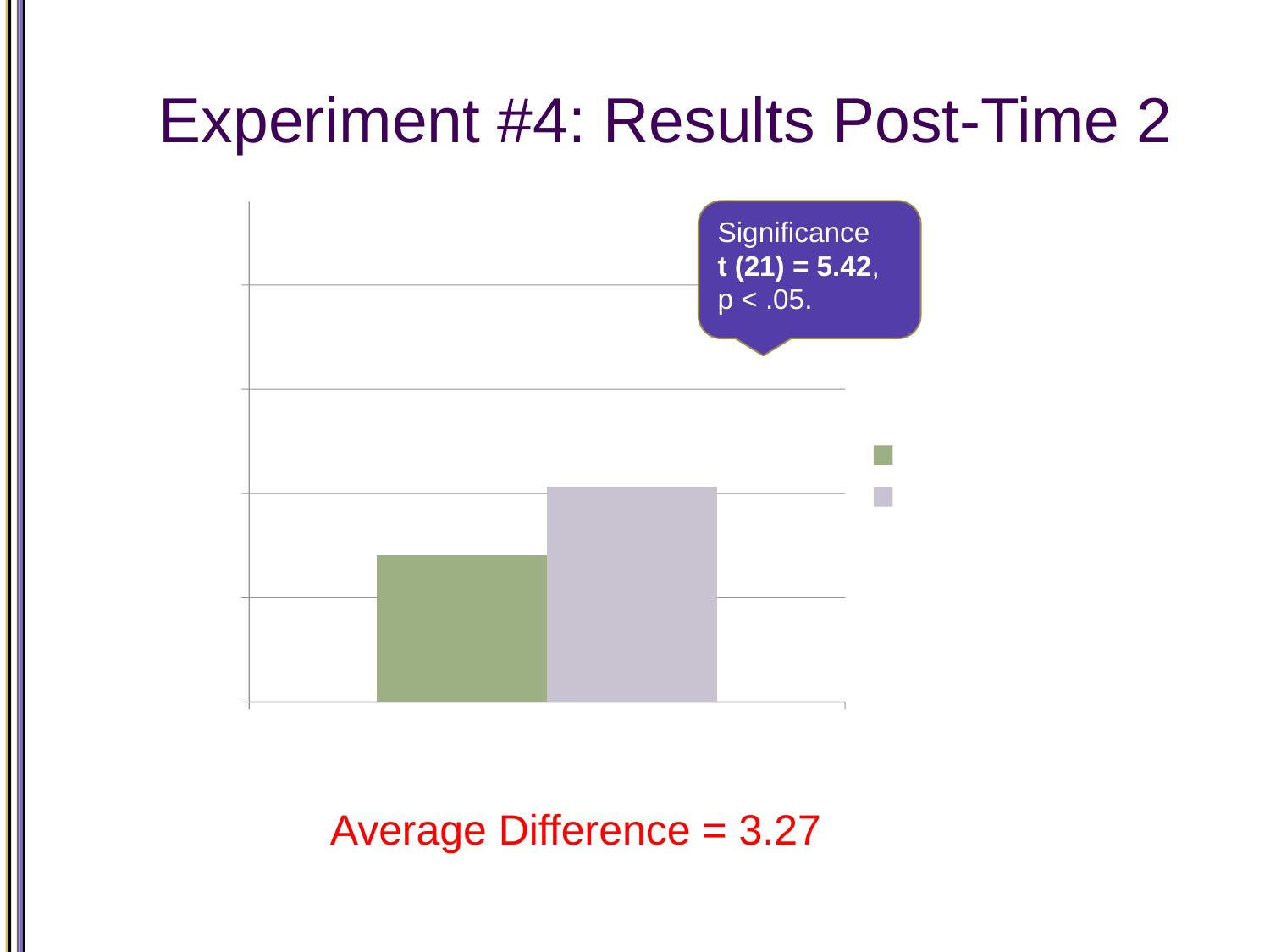
What kind of chart is shown on the slide? bar chart Are the bars in the chart vertical or horizontal? vertical What colours are the two bars in the chart? green and lavender Which bar is taller, the green bar or the lavender bar? the lavender bar How many bars are plotted in the chart? 2 Which bar is the shortest in the chart? the green bar Which bar is the tallest in the chart? the lavender bar How many series does the chart's legend list? 2